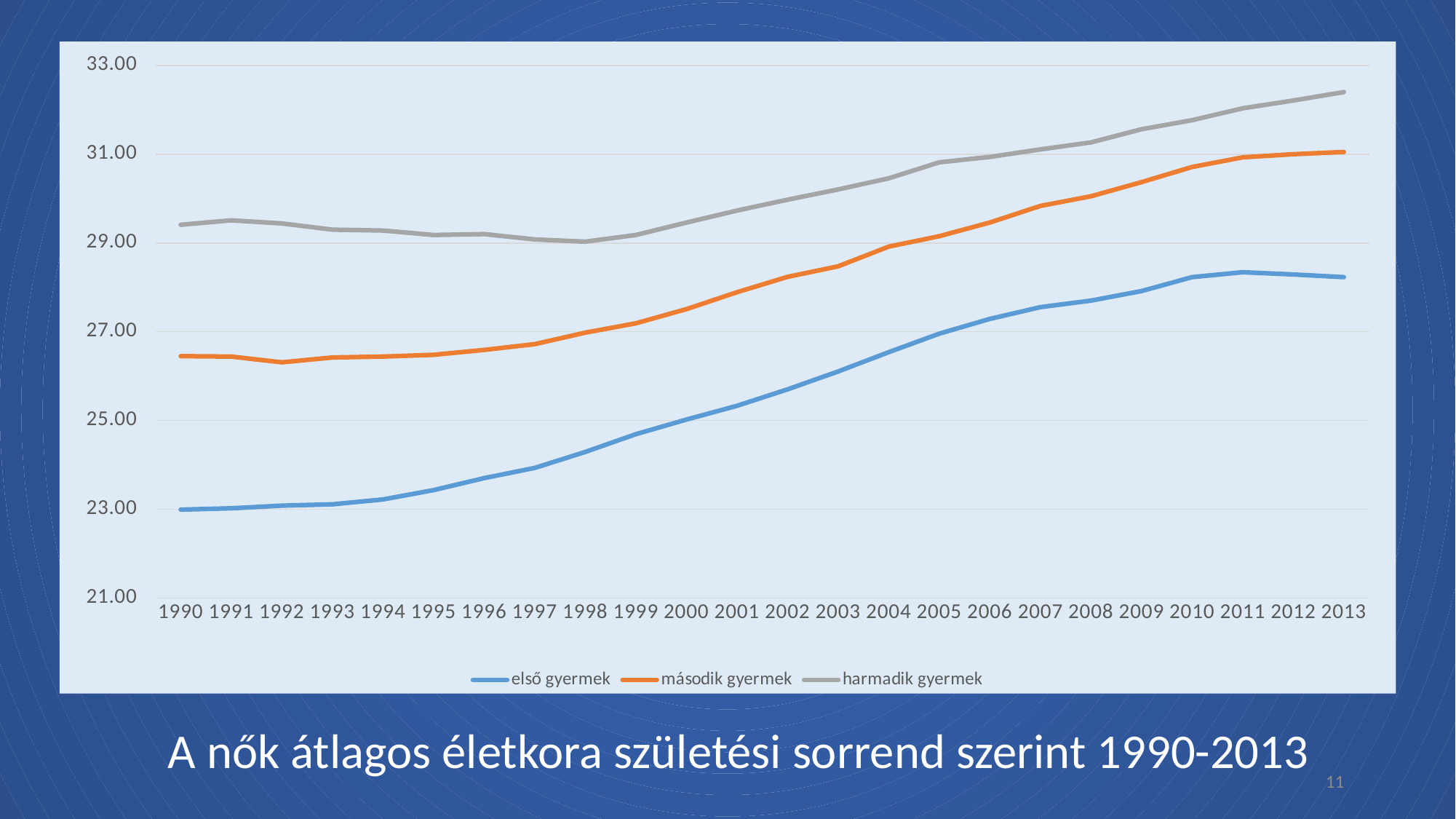
How many series does the legend list? 3 How many years are plotted along the x axis? 24 Which series is drawn in orange? második gyermek In 2013, which is larger: the value for harmadik gyermek or the value for első gyermek? harmadik gyermek Is the value for első gyermek in 2013 greater or less than 27.00? greater Which series has the highest value in 2013? harmadik gyermek Does the első gyermek series rise or fall from 1990 to 2013? rise What kind of chart is shown on the slide? line chart Is the value for második gyermek in 1990 greater or less than 27.00? less Is the value for harmadik gyermek in 2013 greater or less than 31.00? greater What is the title of the chart? A nők átlagos életkora születési sorrend szerint 1990-2013 Which series has the lowest value in 1990? első gyermek